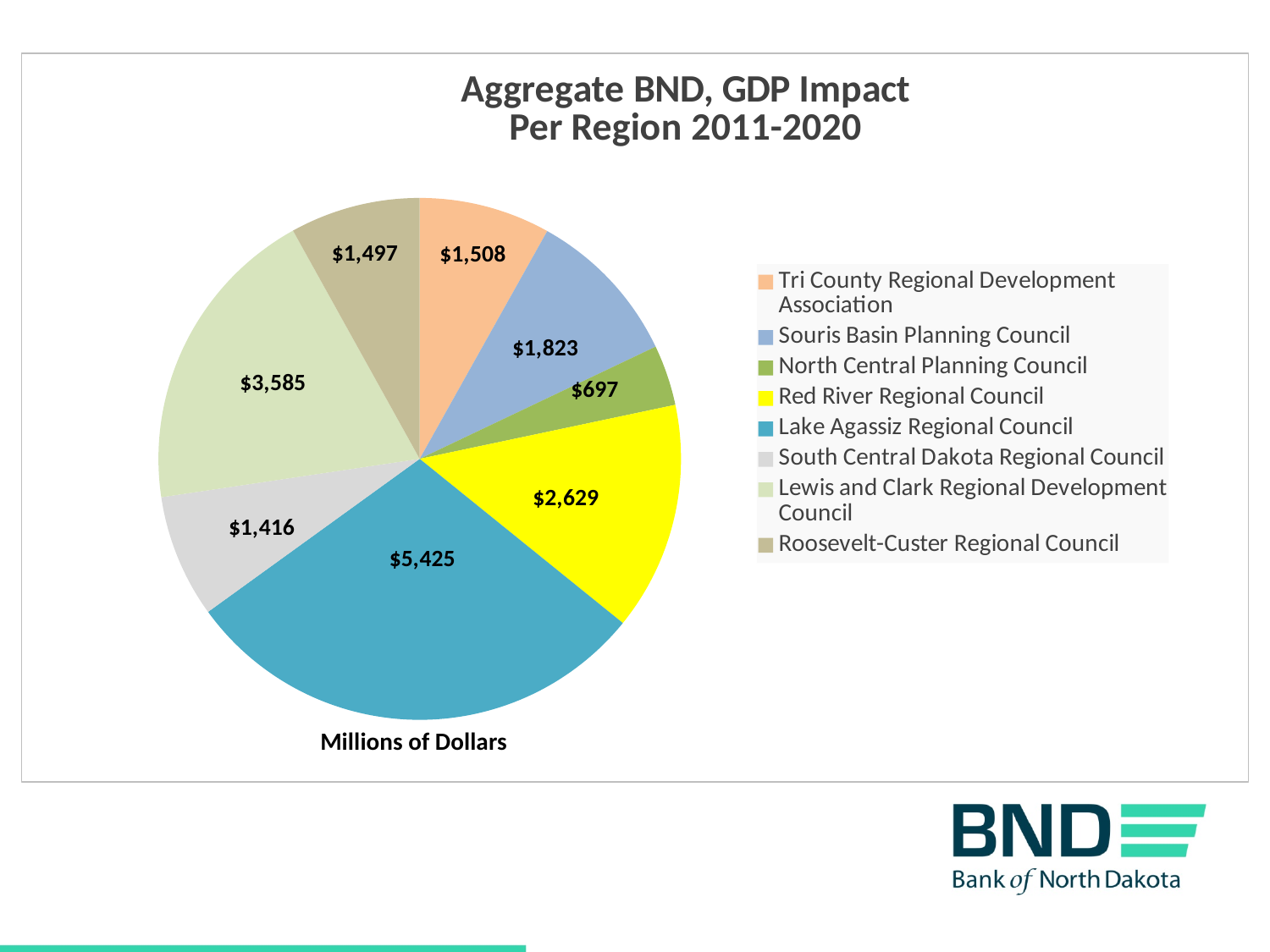
What kind of chart is shown on the slide? Pie chart What is the difference between the values for Red River Regional Council and Souris Basin Planning Council? $806 Which region has the smallest GDP impact? North Central Planning Council Which is larger, the value for Souris Basin Planning Council or the value for Tri County Regional Development Association? Souris Basin Planning Council What is the difference between the values for Lake Agassiz Regional Council and Lewis and Clark Regional Development Council? $1,840 Which region has the largest GDP impact? Lake Agassiz Regional Council What is the value for Lewis and Clark Regional Development Council? $3,585 What is the value for South Central Dakota Regional Council? $1,416 What is the value for North Central Planning Council? $697 How many regions are shown in the pie chart? 8 What is the title of the chart? Aggregate BND, GDP Impact Per Region 2011-2020 What is the value for Lake Agassiz Regional Council? $5,425